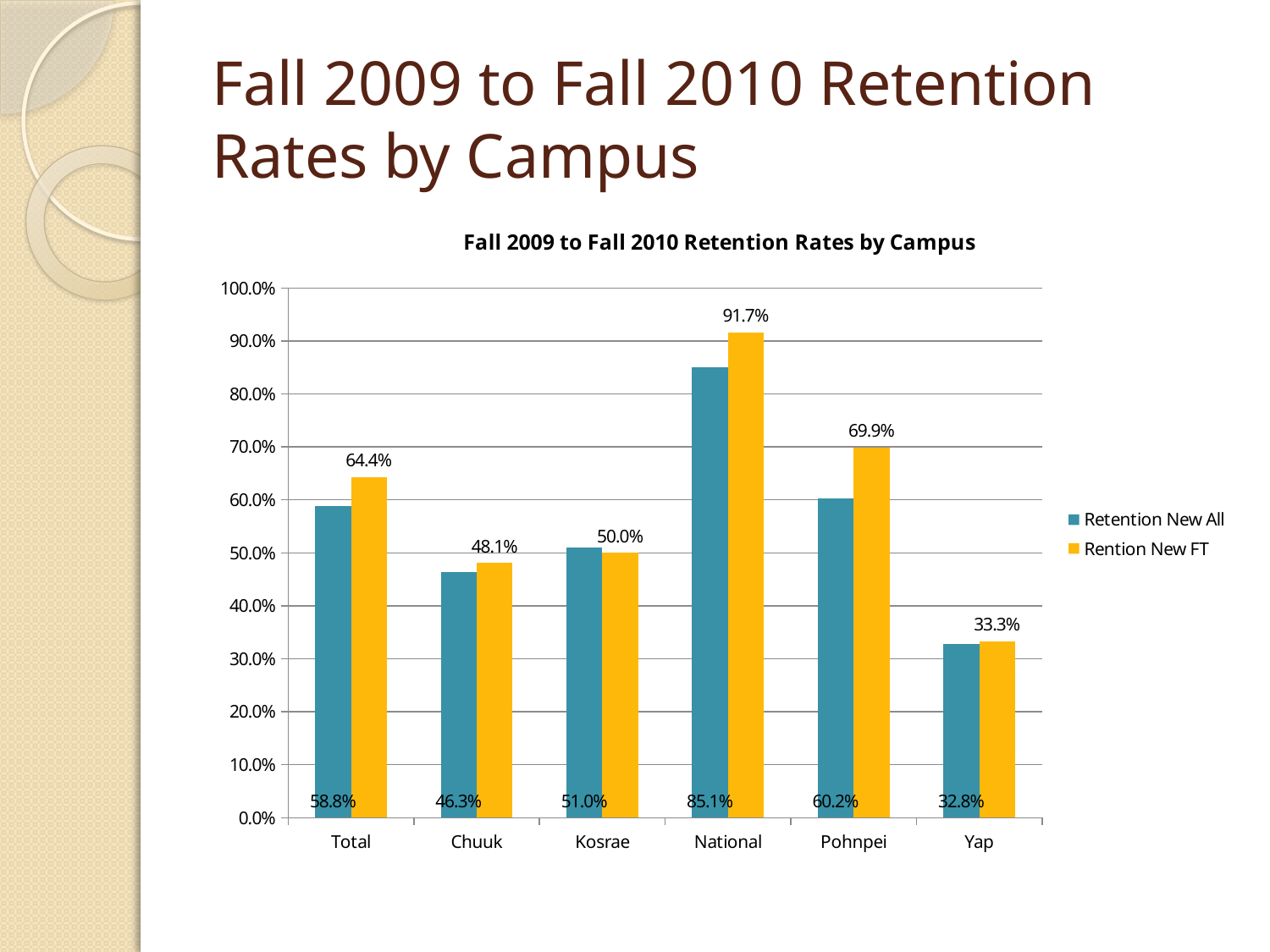
Is the Retention New All value for Pohnpei greater or less than 50.0%? greater What is the difference between the Rention New FT and Retention New All values for Total? 5.6% What is the Rention New FT value for Chuuk? 48.1% Which campus has the highest Rention New FT value? National What is the Rention New FT value for Pohnpei? 69.9% How many campus categories are shown on the x axis? 6 What is the Retention New All value for National? 85.1% What colour are the Rention New FT bars? Yellow How many series does the legend list? 2 For Kosrae, which is larger: Retention New All or Rention New FT? Retention New All What kind of chart is shown on the slide? Bar chart Which campus has the lowest Retention New All value? Yap